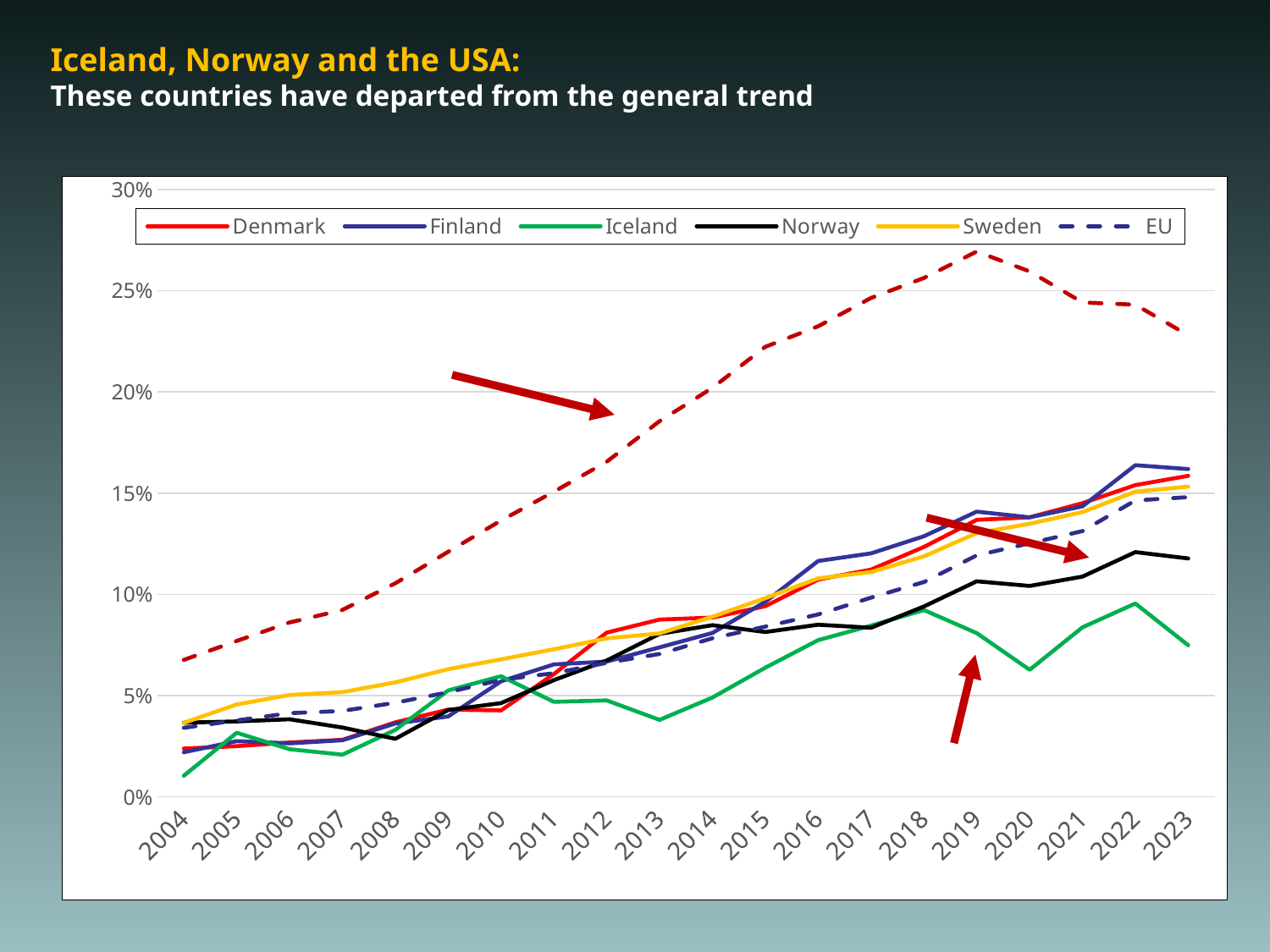
What kind of chart is shown on the slide? line chart Is the value for Finland in 2022 greater or less than 15%? greater What is the title of the slide? Iceland, Norway and the USA: These countries have departed from the general trend Does the Finland line generally rise or fall from 2004 to 2023? rise In 2023, which is higher, Iceland or Norway? Norway Is the value for Norway in 2023 greater or less than 15%? less How many years are shown along the x axis of the chart? 20 How many series does the chart's legend list? 6 Among the series listed in the legend, which has the lowest value in 2023? Iceland In 2023, which is higher, Finland or Norway? Finland Is the value for Iceland in 2023 greater or less than 10%? less